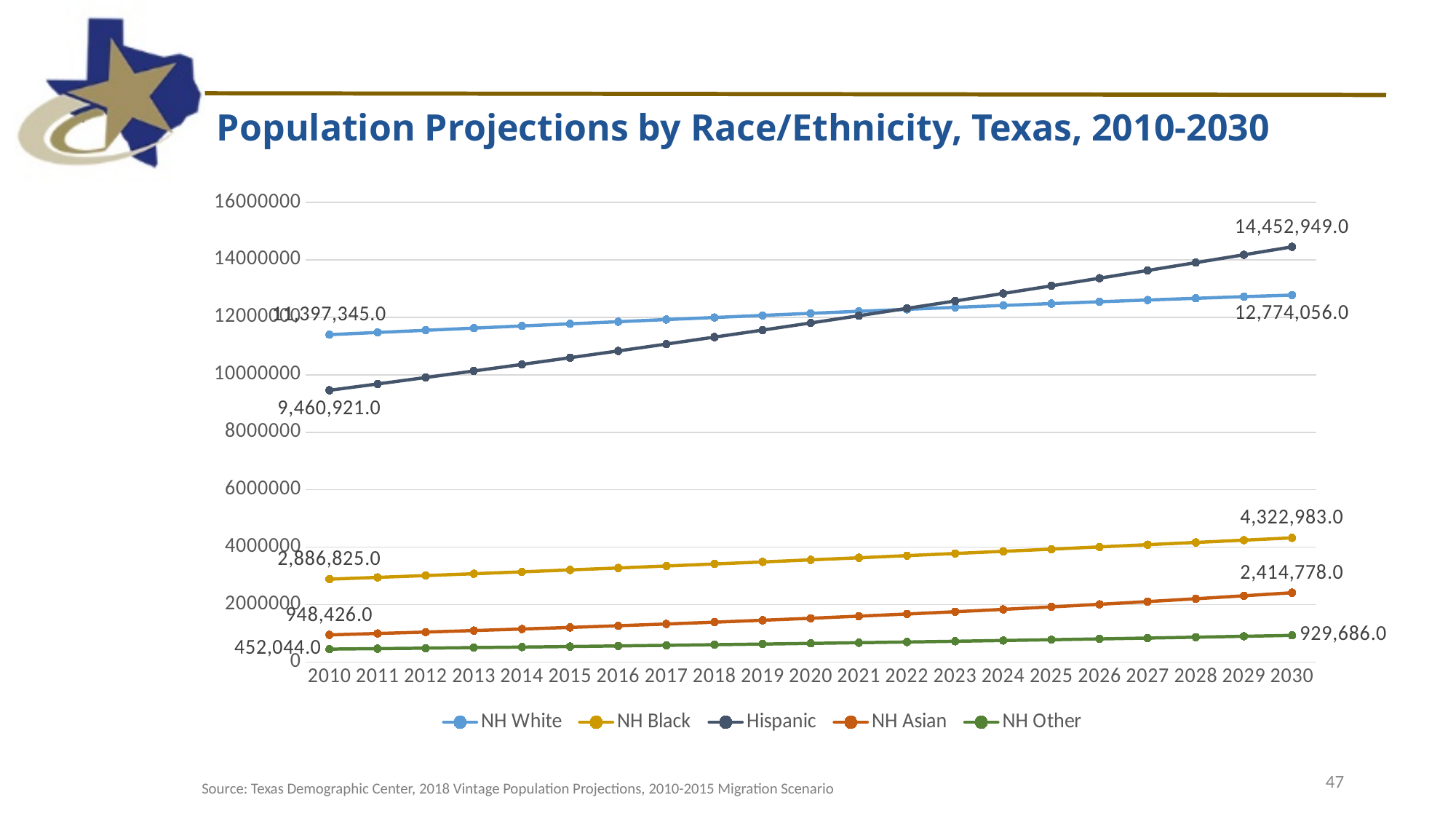
What is the Hispanic population value shown for 2010? 9,460,921.0 Is the NH White value for 2010 greater or less than 12000000? less What is the projected NH Asian population in 2030? 2,414,778.0 What is the projected Hispanic population in 2030? 14,452,949.0 What kind of chart is shown on the slide? line chart Which series has the highest value in 2030? Hispanic What is the projected NH White population in 2030? 12,774,056.0 How many series does the legend list? 5 Which series has the lowest value in 2030? NH Other What is the NH Other population value shown for 2010? 452,044.0 What is the NH Black population value shown for 2010? 2,886,825.0 By how much does the Hispanic population increase from 2010 to 2030? 4,992,028.0